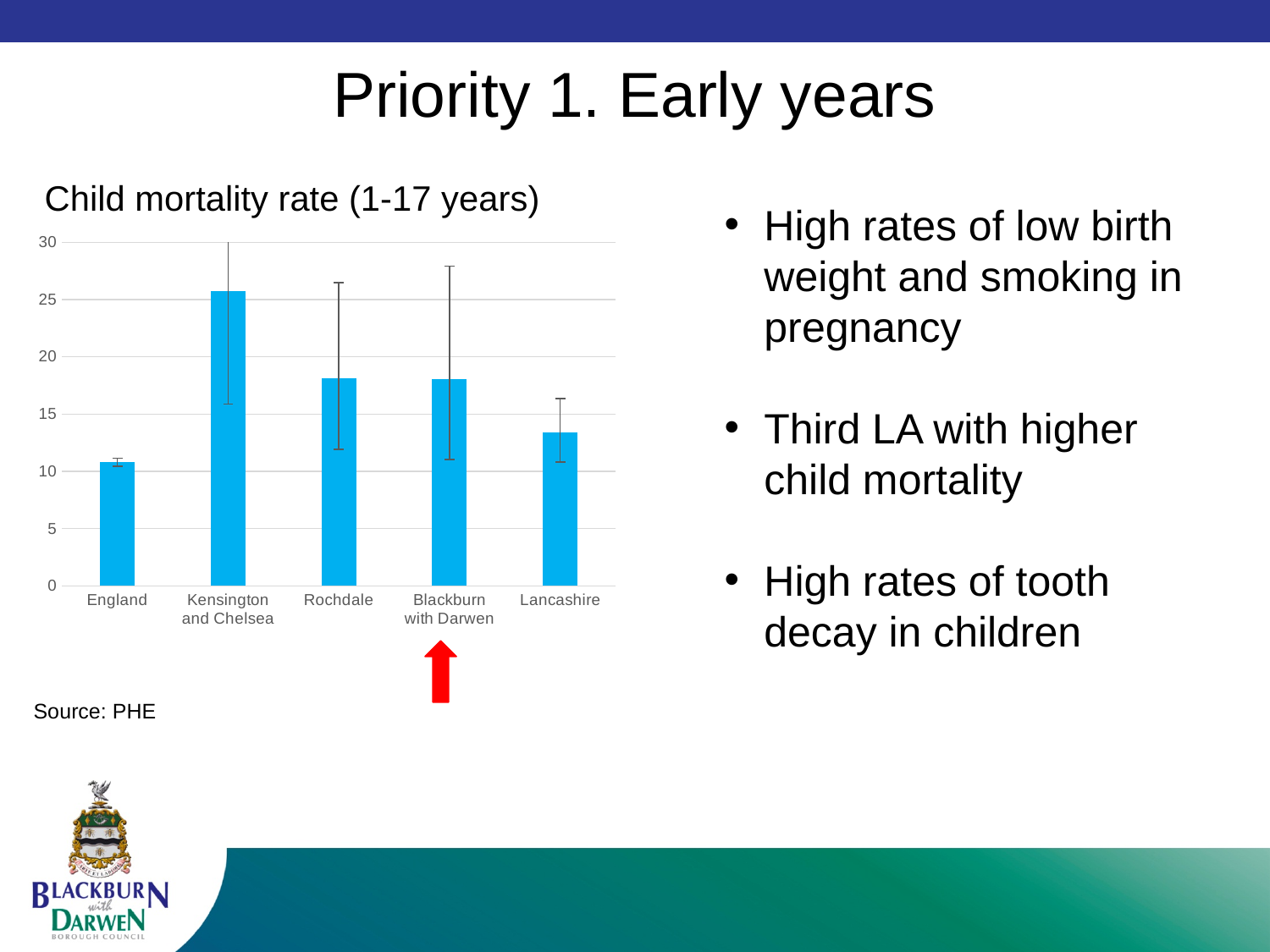
Is the value for Rochdale greater or less than 15? greater Which category has the highest child mortality rate in the chart? Kensington and Chelsea Is the value for Lancashire greater or less than 15? less What is the title of the chart? Child mortality rate (1-17 years) What is the source cited for the chart? PHE Which category has the lowest child mortality rate in the chart? England Which has a higher child mortality rate, England or Lancashire? Lancashire Is the value for England greater or less than 15? less How many categories are shown on the x axis of the chart? 5 What kind of chart is shown on the slide? bar chart Which has a higher child mortality rate, Kensington and Chelsea or Rochdale? Kensington and Chelsea